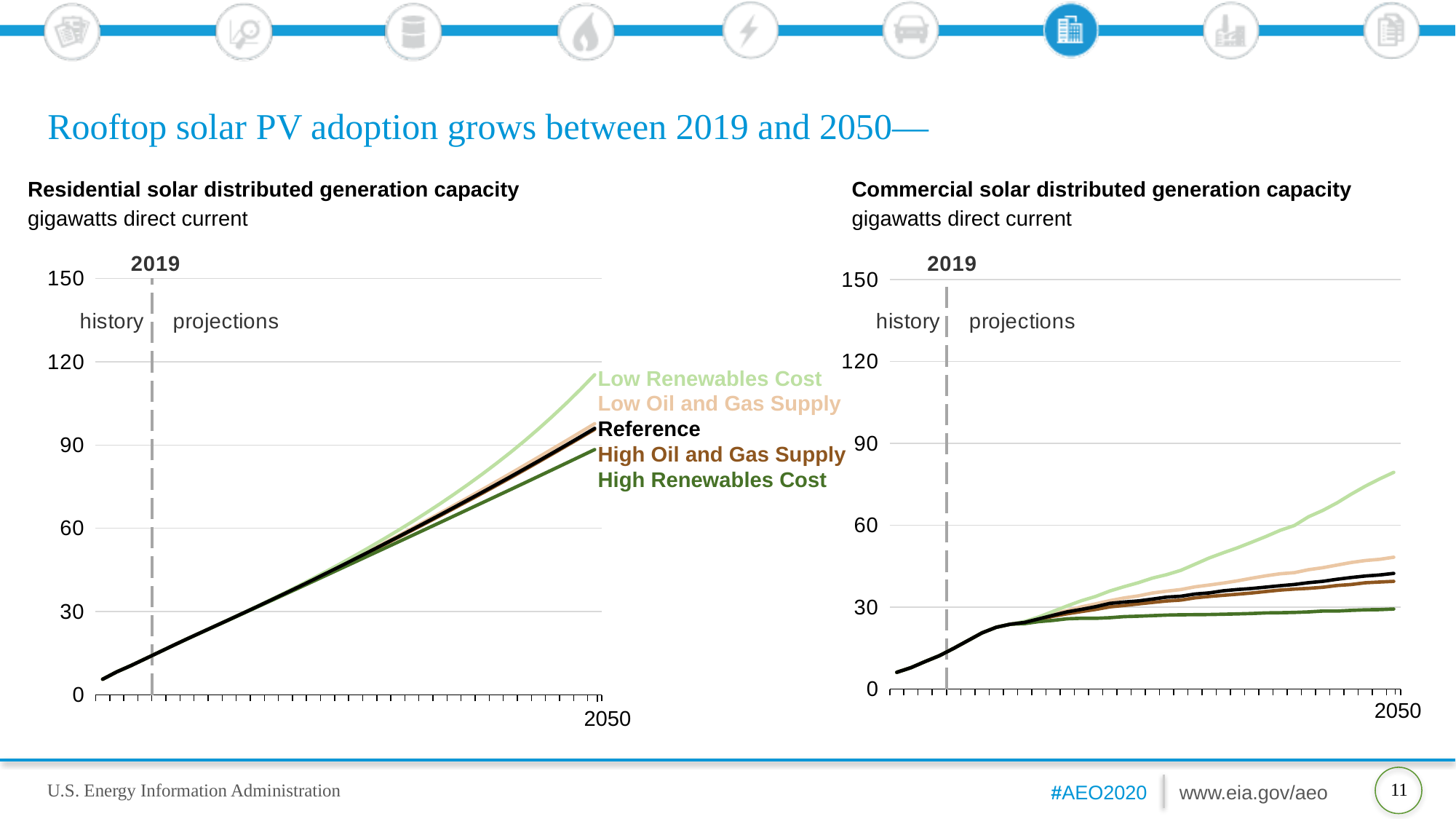
In the Residential solar distributed generation capacity chart, does the Reference series rise or fall from 2019 to 2050? rise In the Commercial solar distributed generation capacity chart, which series is highest in 2050? Low Renewables Cost In the Commercial solar distributed generation capacity chart, which series is lowest in 2050? High Renewables Cost In the Residential solar distributed generation capacity chart, is the Low Renewables Cost value in 2050 greater or less than 90? greater What year does the dashed vertical line mark in the Residential solar distributed generation capacity chart? 2019 In the Commercial solar distributed generation capacity chart, is the Low Renewables Cost value in 2050 greater or less than 60? greater What kind of chart is the Residential solar distributed generation capacity chart? line chart How many series does the legend list for the solar distributed generation capacity charts? 5 In the Commercial solar distributed generation capacity chart, which is larger in 2050: Low Renewables Cost or High Renewables Cost? Low Renewables Cost In the Residential solar distributed generation capacity chart, which series is highest in 2050? Low Renewables Cost What unit is used on the y axis of the Commercial solar distributed generation capacity chart? gigawatts direct current In the Commercial solar distributed generation capacity chart, is the High Renewables Cost value in 2050 greater or less than 60? less